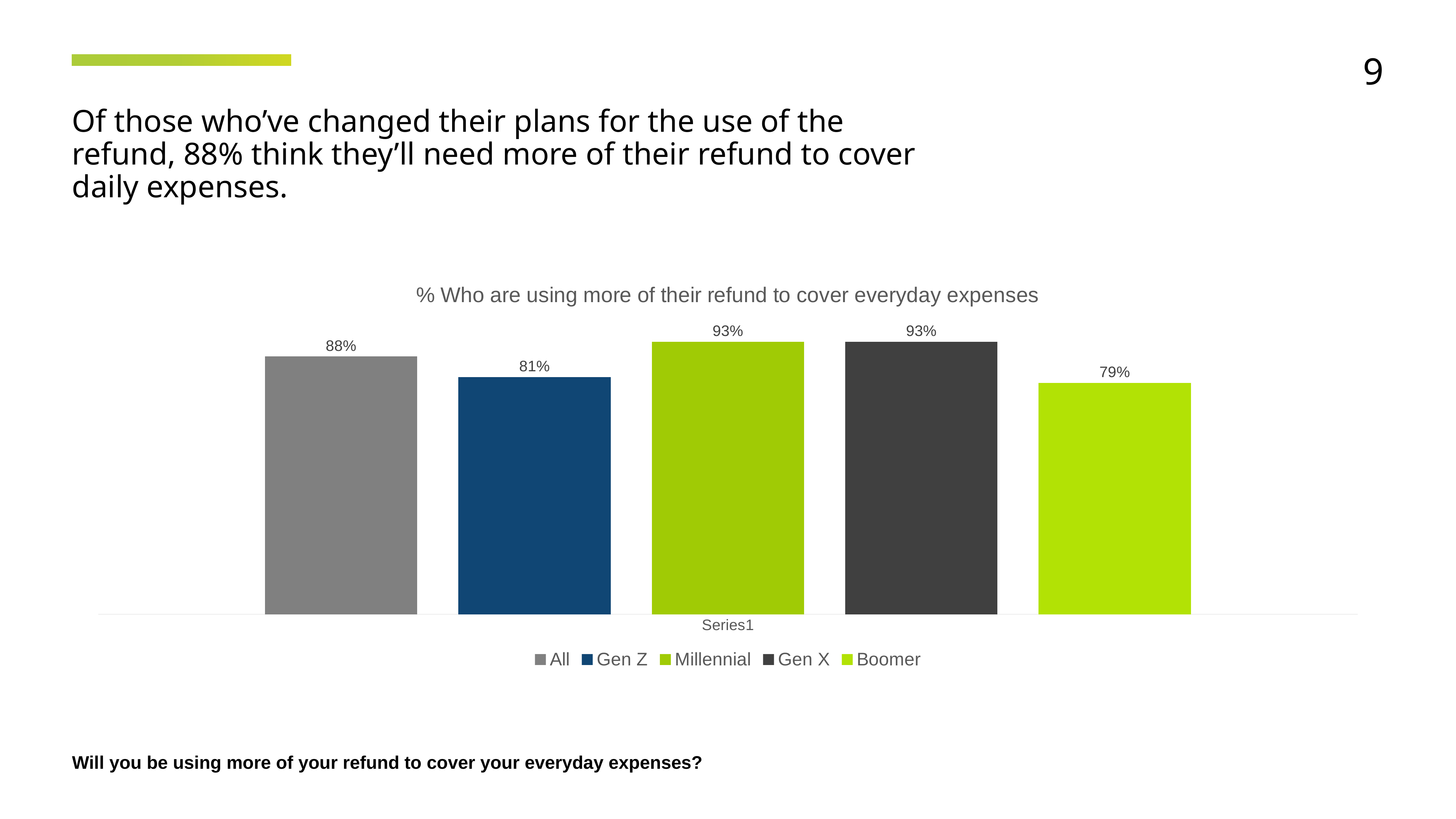
What kind of chart is shown? Bar chart Which group has the lowest value? Boomer What is the value for Boomer? 79% Which is larger, the value for All or the value for Millennial? Millennial What is the difference between the values for All and Gen Z? 7% What is the value for Gen X? 93% What is the value for Gen Z? 81% What is the difference between the values for Millennial and Boomer? 14% What is the value for All? 88% How many series does the legend list? 5 Which is larger, the value for Gen Z or the value for Boomer? Gen Z What is the title of the chart? % Who are using more of their refund to cover everyday expenses